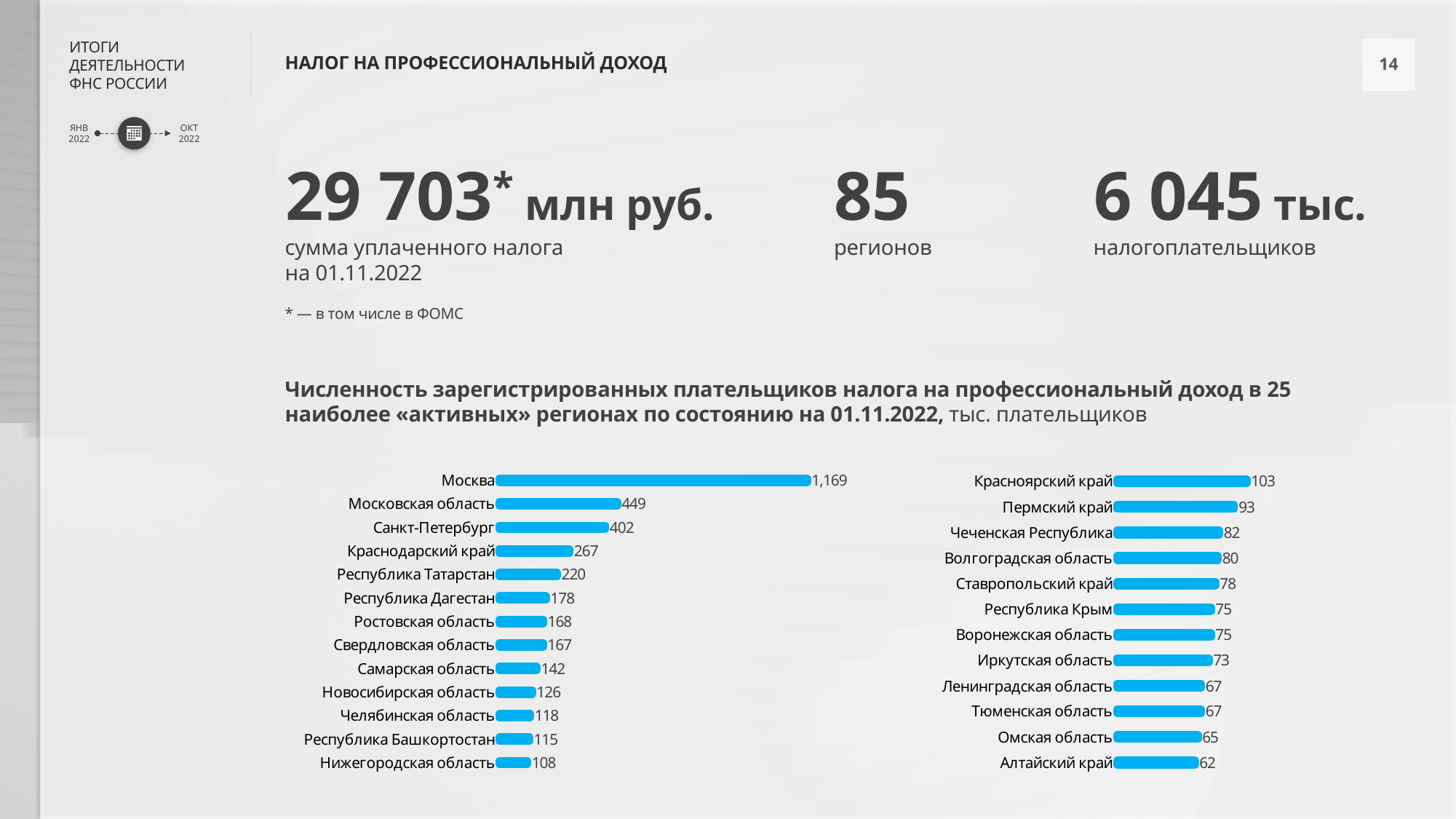
In the right chart, what is the value for Пермский край? 93 In the left chart, which is larger: the value for Краснодарский край or the value for Республика Татарстан? Краснодарский край In the left chart, what is the value for Санкт-Петербург? 402 How many regions are shown in the left chart? 13 How many regions are shown in the right chart? 12 In the right chart, which region has the lowest value? Алтайский край What kind of chart is used to show the number of registered taxpayers by region? bar chart In the left chart, which region has the highest value? Москва In the right chart, what is the value for Омская область? 65 In the left chart, what is the difference between the values for Московская область and Санкт-Петербург? 47 In the right chart, what is the difference between the values for Красноярский край and Чеченская Республика? 21 In the left chart, what is the value for Москва? 1,169